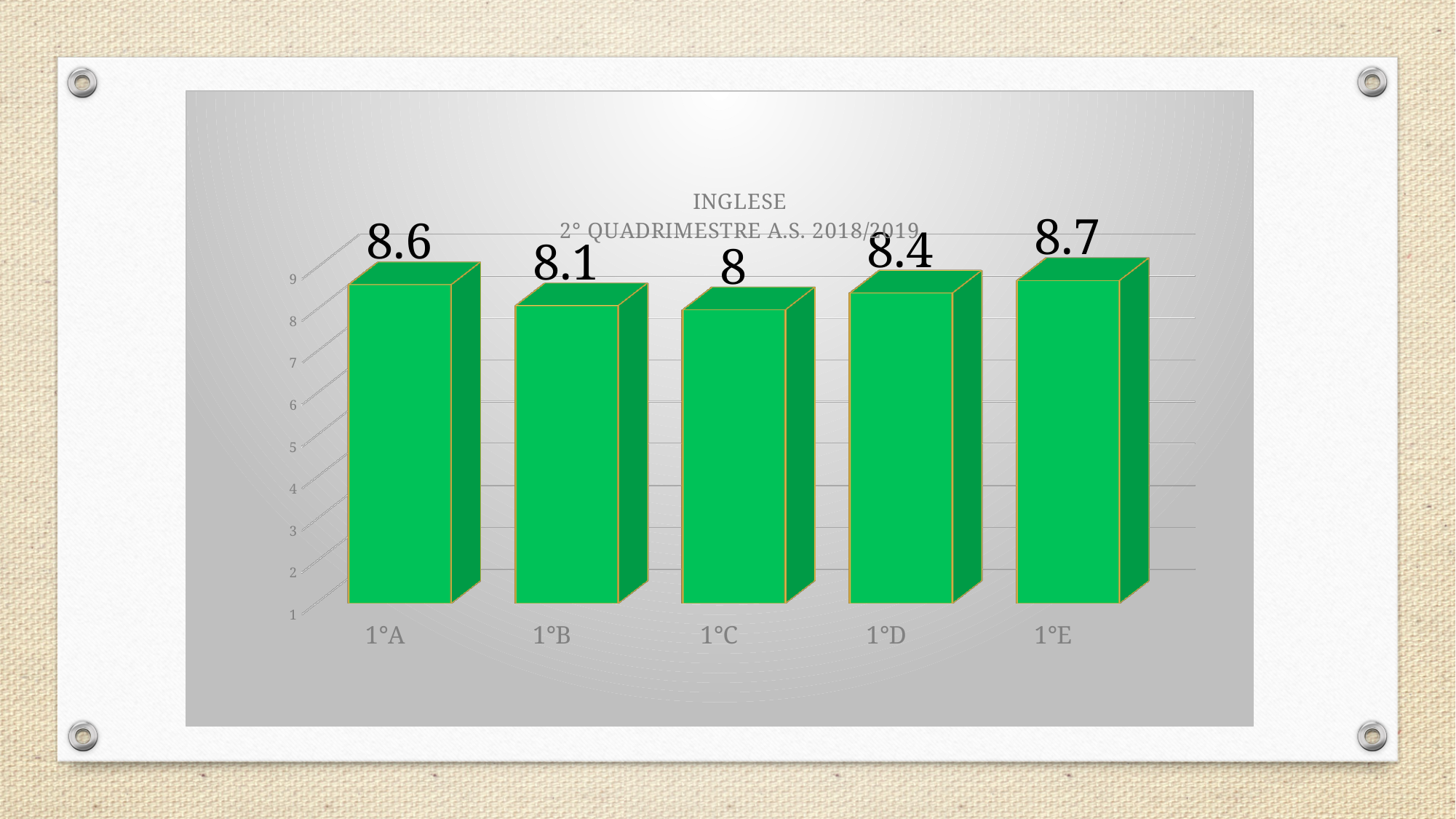
What colour are the bars? green Which class has the lowest value? 1°C What kind of chart is shown? bar chart What is the title of the chart? INGLESE 2° QUADRIMESTRE A.S. 2018/2019 Which class has the highest value? 1°E What is the difference between the values for 1°E and 1°B? 0.6 What is the value for 1°C? 8 What is the value for 1°A? 8.6 What is the value for 1°D? 8.4 How many classes are shown on the x axis? 5 What is the difference between the values for 1°A and 1°C? 0.6 Which has a larger value, 1°B or 1°D? 1°D